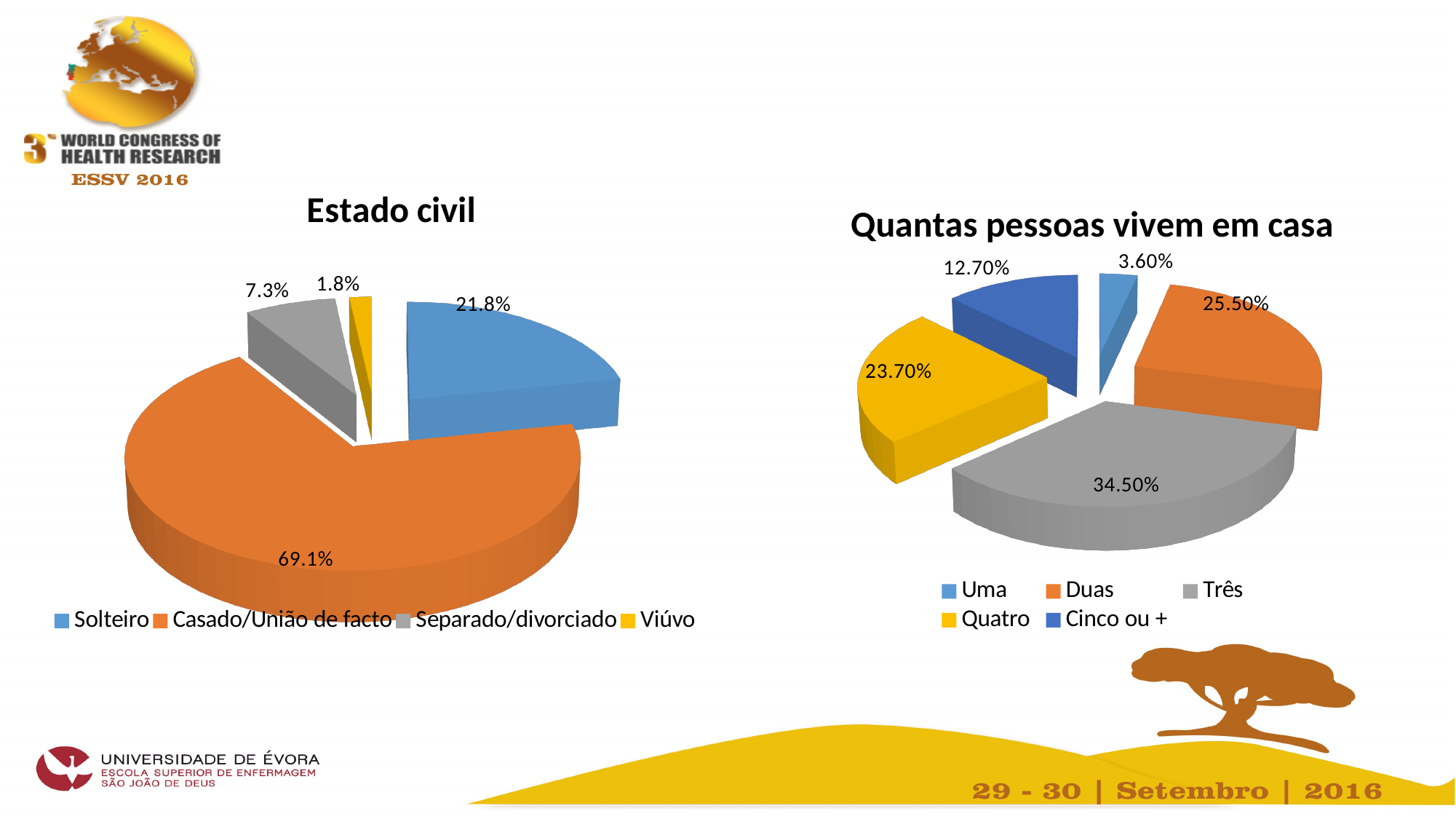
In the 'Estado civil' chart, what percentage is shown for Casado/União de facto? 69.1% What type of chart is the 'Estado civil' chart? Pie chart In the 'Quantas pessoas vivem em casa' chart, which is larger, Duas or Quatro? Duas In the 'Estado civil' chart, what percentage is shown for Viúvo? 1.8% In the 'Quantas pessoas vivem em casa' chart, what is the difference between the Duas and Uma shares? 21.90% In the 'Quantas pessoas vivem em casa' chart, what percentage is shown for Cinco ou +? 12.70% In the 'Estado civil' chart, what is the difference between the Solteiro and Separado/divorciado shares? 14.5% In the 'Estado civil' chart, how many categories does the legend list? 4 In the 'Quantas pessoas vivem em casa' chart, what percentage is shown for Três? 34.50% In the 'Quantas pessoas vivem em casa' chart, which category has the largest share? Três In the 'Estado civil' chart, which category has the smallest share? Viúvo In the 'Quantas pessoas vivem em casa' chart, which colour represents Quatro? Yellow